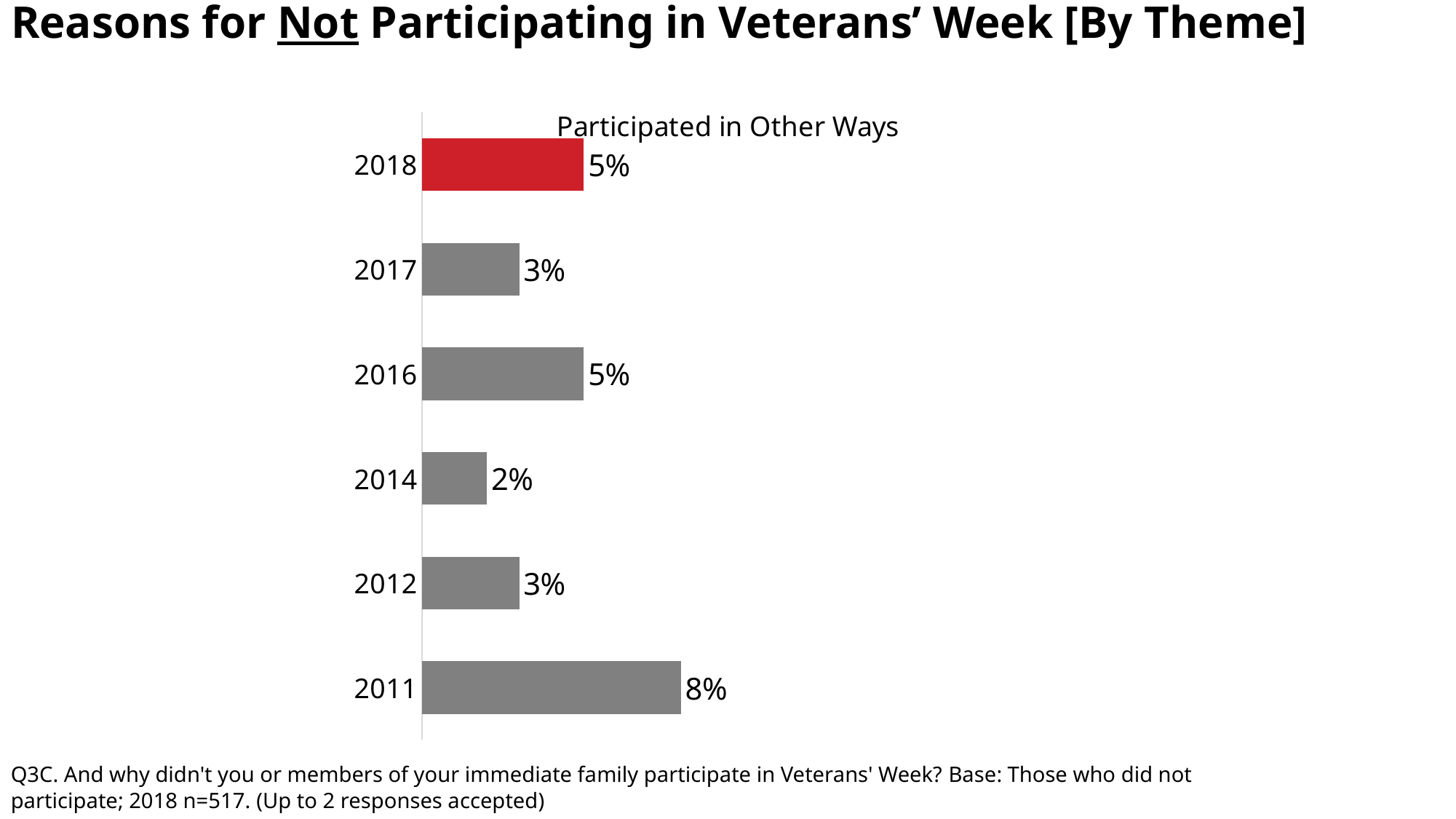
What is the value for 2011 in the Participated in Other Ways chart? 8% What kind of chart is shown on the slide? Bar chart Which year has the lowest value in the Participated in Other Ways chart? 2014 What is the value for 2018 in the Participated in Other Ways chart? 5% How many years are shown in the Participated in Other Ways chart? 6 Which year has the highest value in the Participated in Other Ways chart? 2011 What is the difference between the values for 2011 and 2018 in the Participated in Other Ways chart? 3% What is the value for 2017 in the Participated in Other Ways chart? 3% Which year's bar is highlighted in red in the Participated in Other Ways chart? 2018 What is the difference between the values for 2018 and 2017 in the Participated in Other Ways chart? 2% What is the value for 2014 in the Participated in Other Ways chart? 2% Which is larger in the Participated in Other Ways chart, the value for 2016 or the value for 2014? 2016